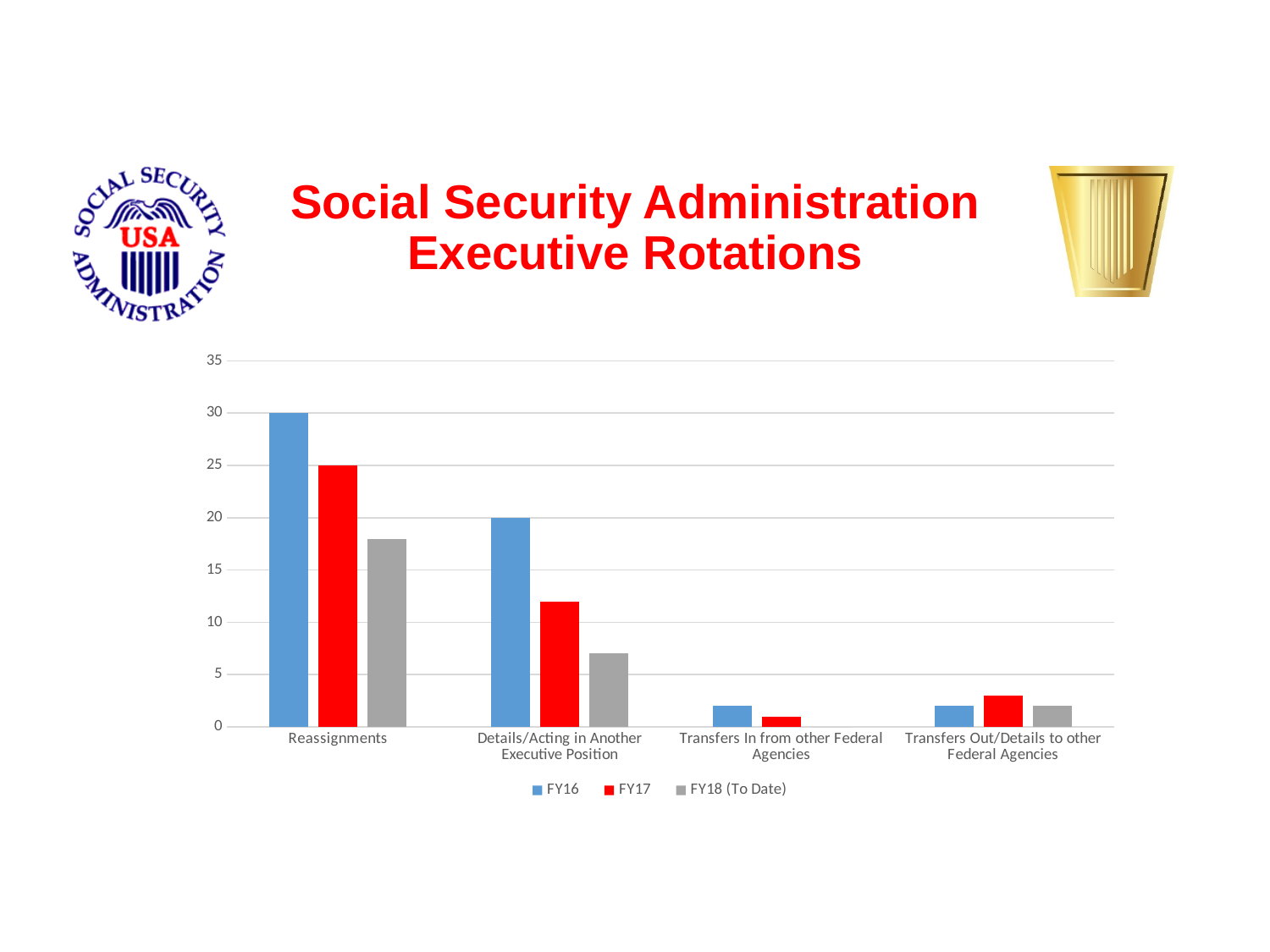
How many series does the legend list? 3 Is the FY18 (To Date) value for Reassignments greater or less than 15? greater Is the FY17 value for Details/Acting in Another Executive Position greater or less than 15? less What is the difference between the FY16 and FY17 values for Reassignments? 5 What is the FY16 value for Reassignments? 30 Which category has the highest FY16 value? Reassignments What type of chart is shown on the slide? Bar chart What is the FY16 value for Details/Acting in Another Executive Position? 20 How many categories are shown on the x axis? 4 Which is larger for Transfers Out/Details to other Federal Agencies, the FY16 value or the FY17 value? FY17 Which category has the lowest FY17 value? Transfers In from other Federal Agencies What is the FY17 value for Reassignments? 25